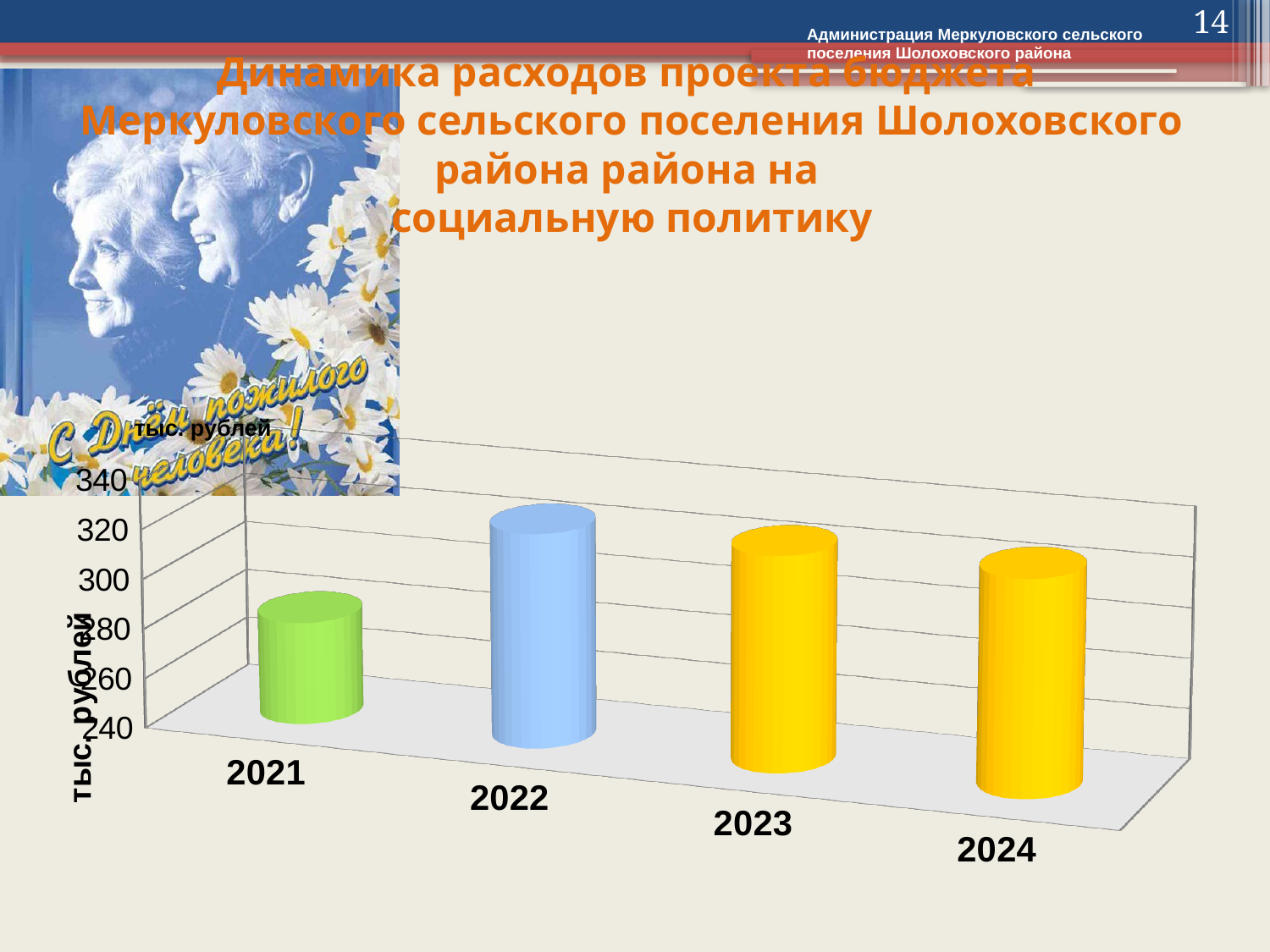
What unit is given on the vertical axis of the chart? тыс. рублей Which year has the lowest value in the chart? 2021 Is the value for 2024 greater or less than 260? greater How many years are shown on the x axis of the chart? 4 Which is larger, the value for 2021 or the value for 2023? 2023 Is the value for 2021 greater or less than 300? less Is the value for 2023 greater or less than 280? greater What kind of chart is shown on the slide? bar chart